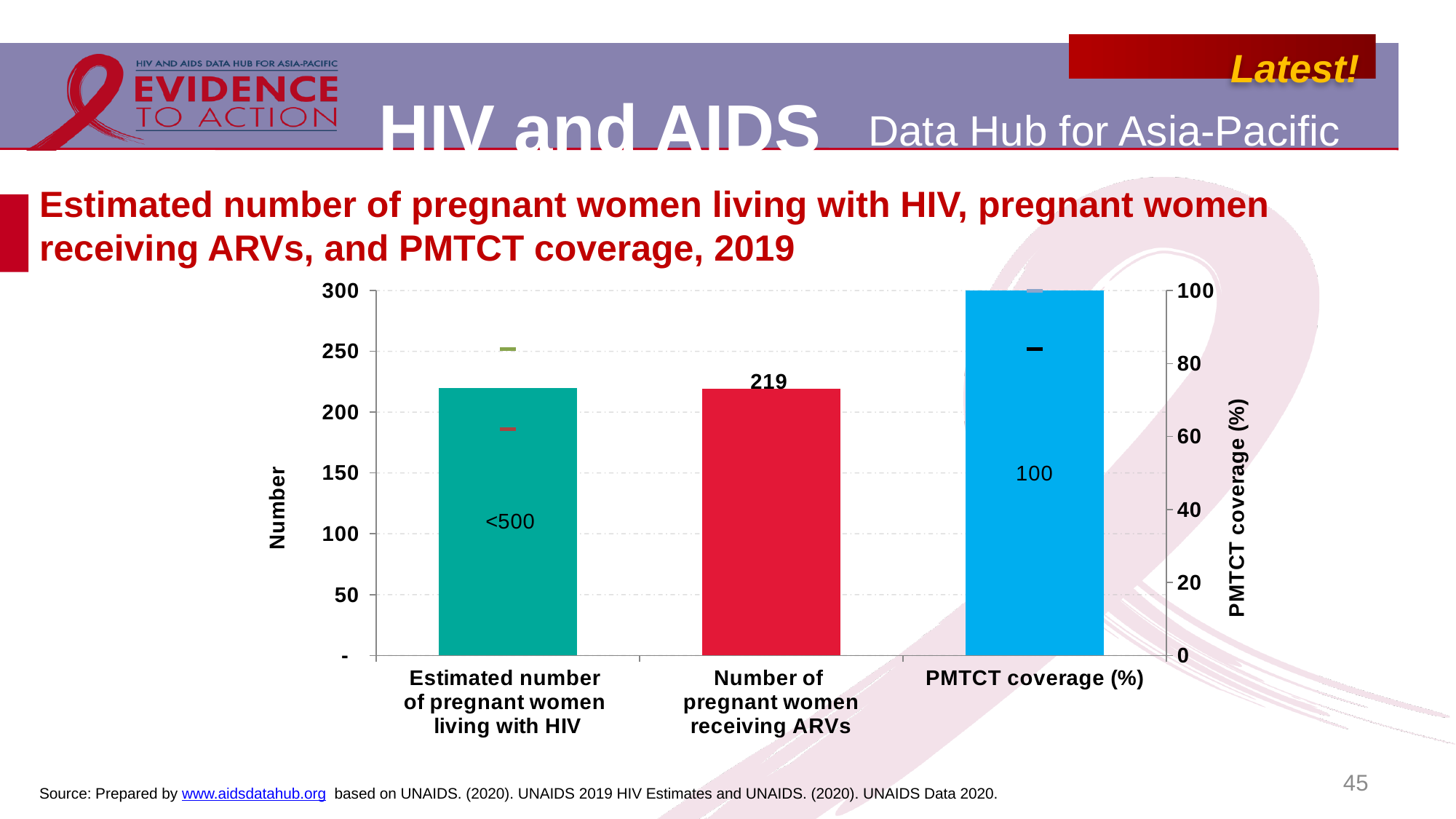
What is the value shown for the number of pregnant women receiving ARVs? 219 What is the value shown for PMTCT coverage (%)? 100 What label is printed on the bar for the estimated number of pregnant women living with HIV? <500 What year does the chart's data refer to? 2019 Is the value for the number of pregnant women receiving ARVs greater or less than 250 on the left axis? less How many categories are shown on the x axis of the chart? 3 What is the maximum value shown on the right-hand axis of the chart? 100 What kind of chart is shown on the slide? bar chart What is the label of the right-hand vertical axis of the chart? PMTCT coverage (%) Is the value for the number of pregnant women receiving ARVs greater or less than 200 on the left axis? greater What is the title of the chart on the slide? Estimated number of pregnant women living with HIV, pregnant women receiving ARVs, and PMTCT coverage, 2019